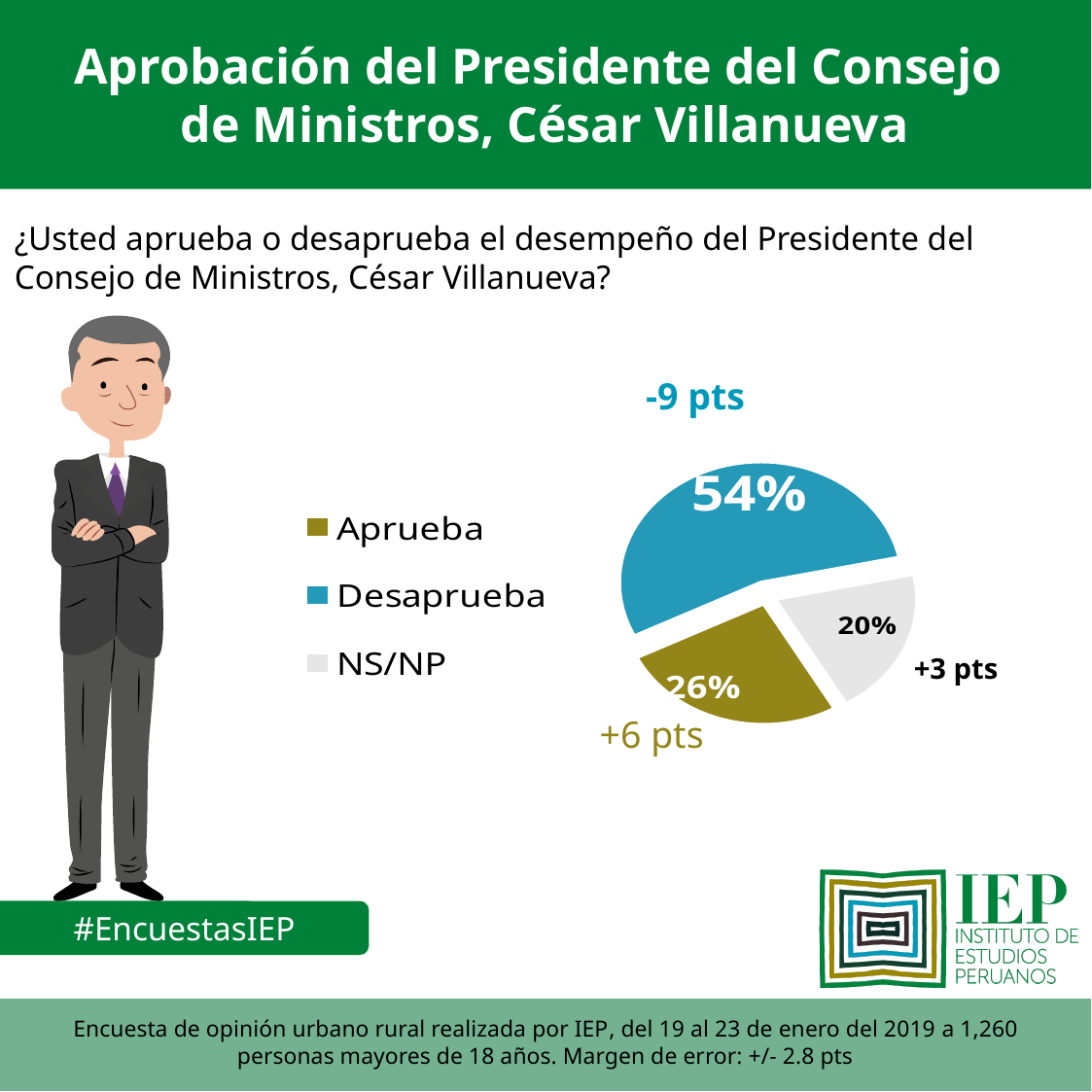
What change in points is shown next to the Aprueba slice? +6 pts How many slices does the pie chart have? 3 Which is larger, the share for Aprueba or the share for NS/NP? Aprueba What is the difference in percentage points between Desaprueba and Aprueba? 28 What change in points is shown next to the Desaprueba slice? -9 pts What is the combined share of Aprueba and Desaprueba? 80% What percentage of respondents answered Aprueba? 26% What percentage of respondents answered Desaprueba? 54% What percentage of respondents answered NS/NP? 20% Which response has the smallest share of the pie? NS/NP Which response has the largest share of the pie? Desaprueba What kind of chart is shown on the slide? Pie chart